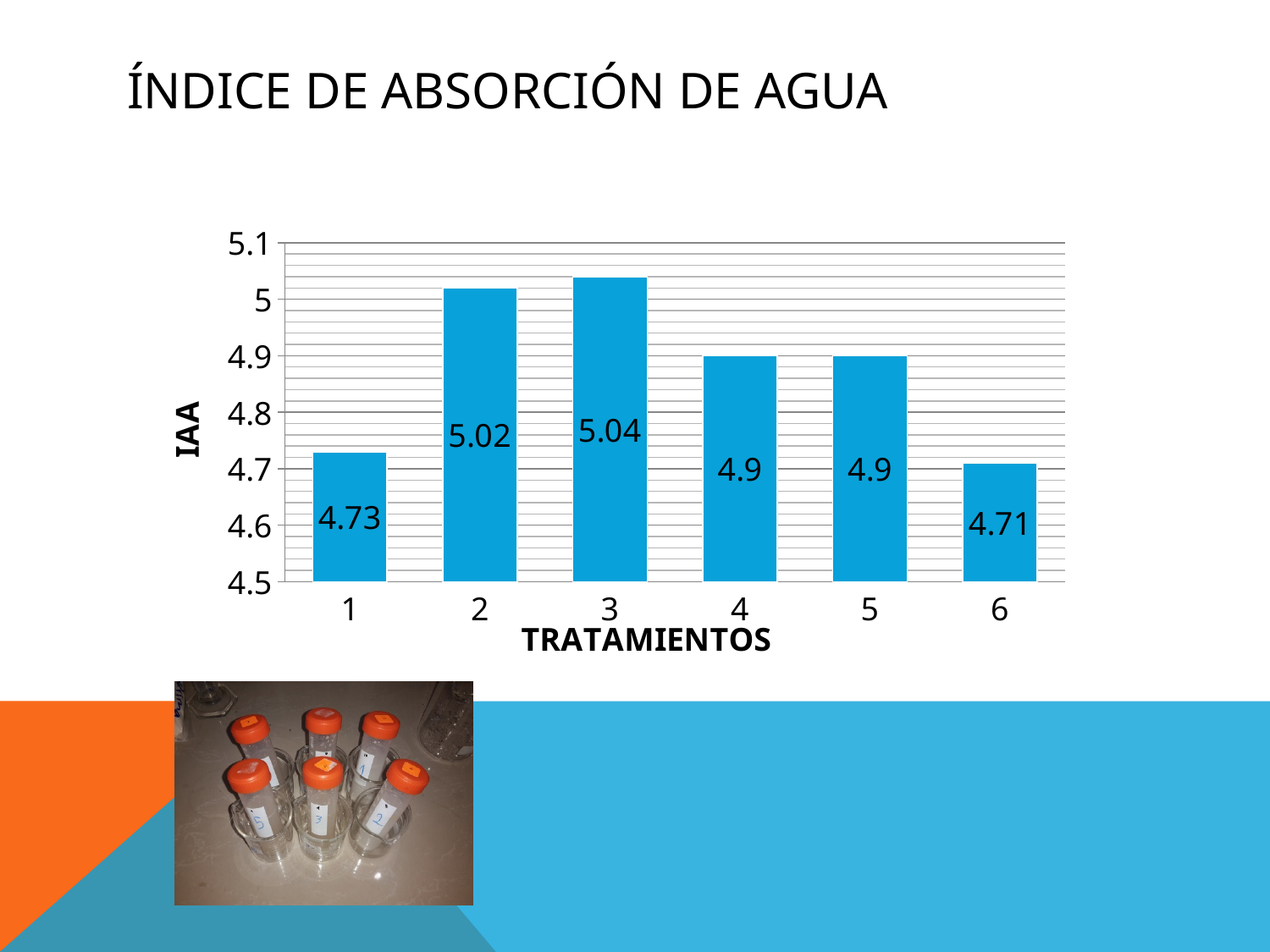
What is the difference in IAA between tratamiento 2 and tratamiento 1? 0.29 What is the IAA value for tratamiento 3? 5.04 Which has a larger IAA value, tratamiento 2 or tratamiento 4? Tratamiento 2 How many tratamientos are shown on the chart? 6 What is the difference in IAA between tratamiento 3 and tratamiento 6? 0.33 What is the IAA value for tratamiento 1? 4.73 What is the IAA value for tratamiento 6? 4.71 Is the IAA value for tratamiento 5 greater or less than 5? less Which tratamiento has the highest IAA value? 3 Which tratamiento has the lowest IAA value? 6 What is the label of the vertical axis of the chart? IAA What kind of chart is shown on the slide? Bar chart